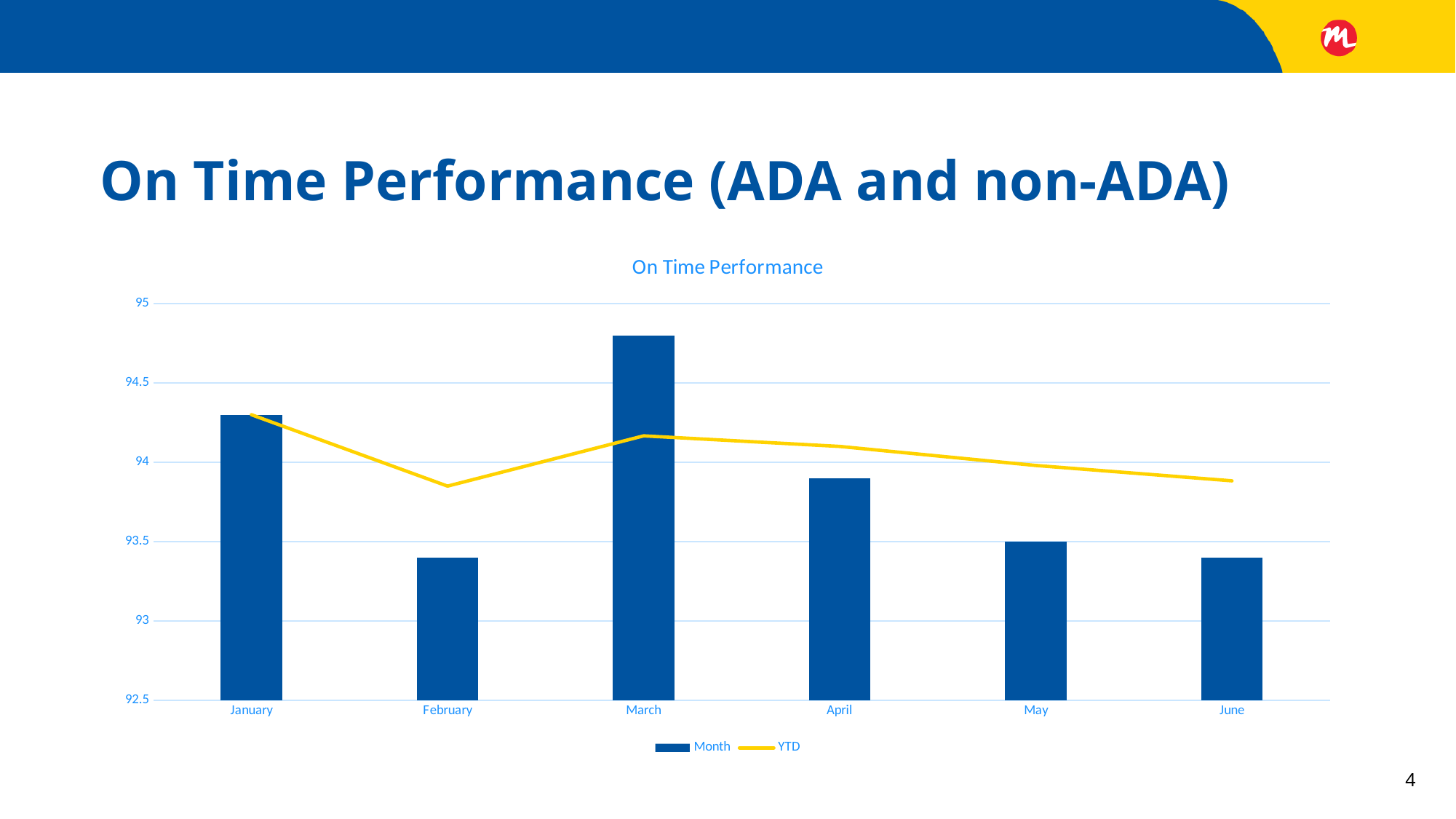
Which is larger, the Month value for January or the Month value for April? January Is the Month value for January greater or less than 94? greater What colour is the YTD line in the On Time Performance chart? Yellow Is the YTD value for June greater or less than 94? less Which month has the highest Month bar in the On Time Performance chart? March Does the YTD line rise or fall from March to June? fall Is the Month value for March greater or less than 94.5? greater How many months are shown on the x axis of the On Time Performance chart? 6 What kind of chart is shown on the slide? A combined bar and line chart How many series does the legend of the On Time Performance chart list? 2